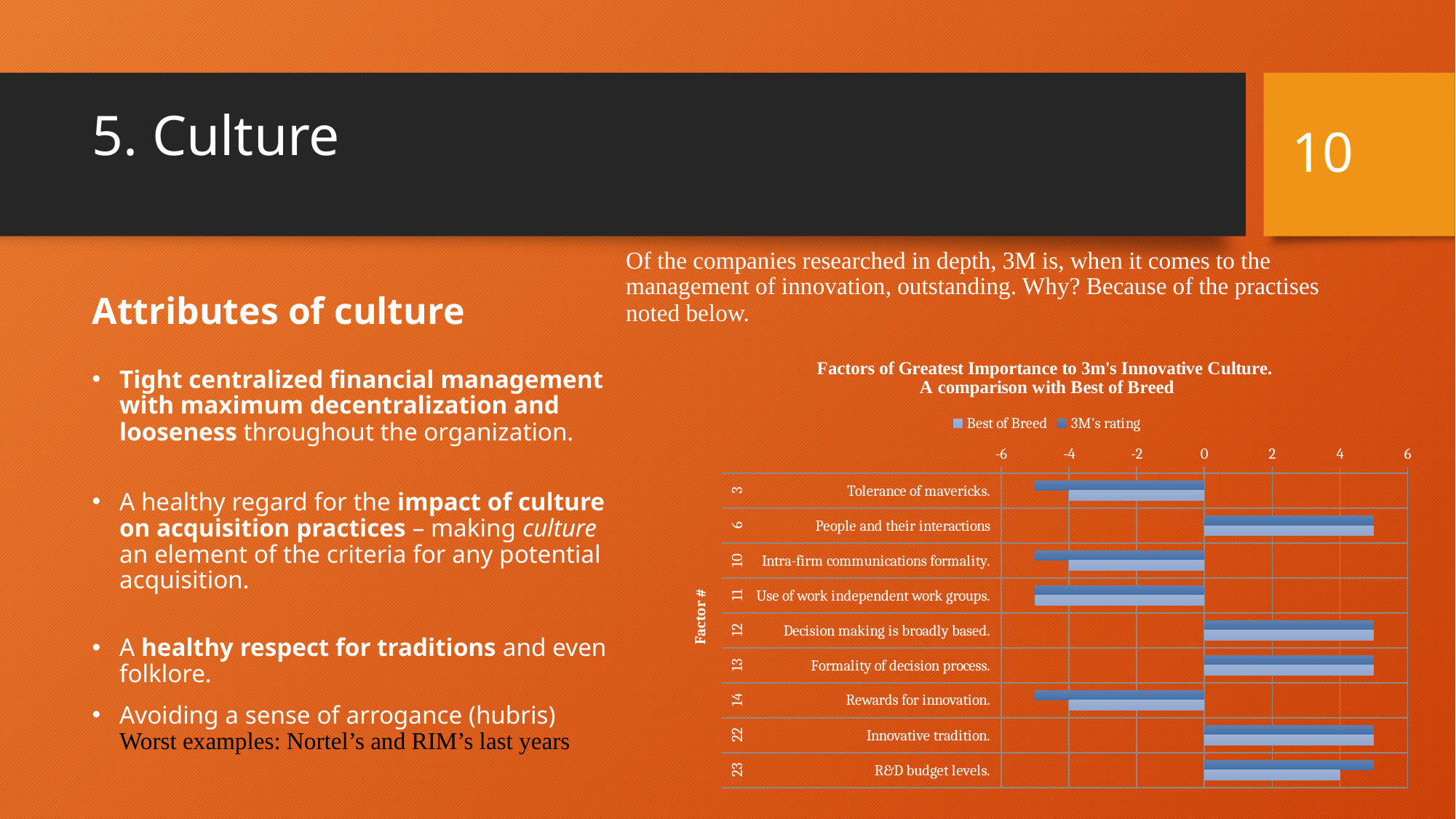
Is the 3M's rating value for "R&D budget levels." greater or less than 2? greater How many factors (categories) are plotted in the chart? 9 What are the two series named in the chart legend? Best of Breed and 3M's rating For "Tolerance of mavericks.", which series has the lower value, Best of Breed or 3M's rating? 3M's rating What kind of chart is shown on the slide? Bar chart What is the title of the chart? Factors of Greatest Importance to 3m's Innovative Culture. A comparison with Best of Breed For "R&D budget levels.", which series has the larger value, Best of Breed or 3M's rating? 3M's rating Is the Best of Breed value for "People and their interactions" greater or less than 4? greater Is the 3M's rating value for "Tolerance of mavericks." greater or less than -2? less How many series does the chart legend list? 2 How many factors in the chart have negative values for both series? 4